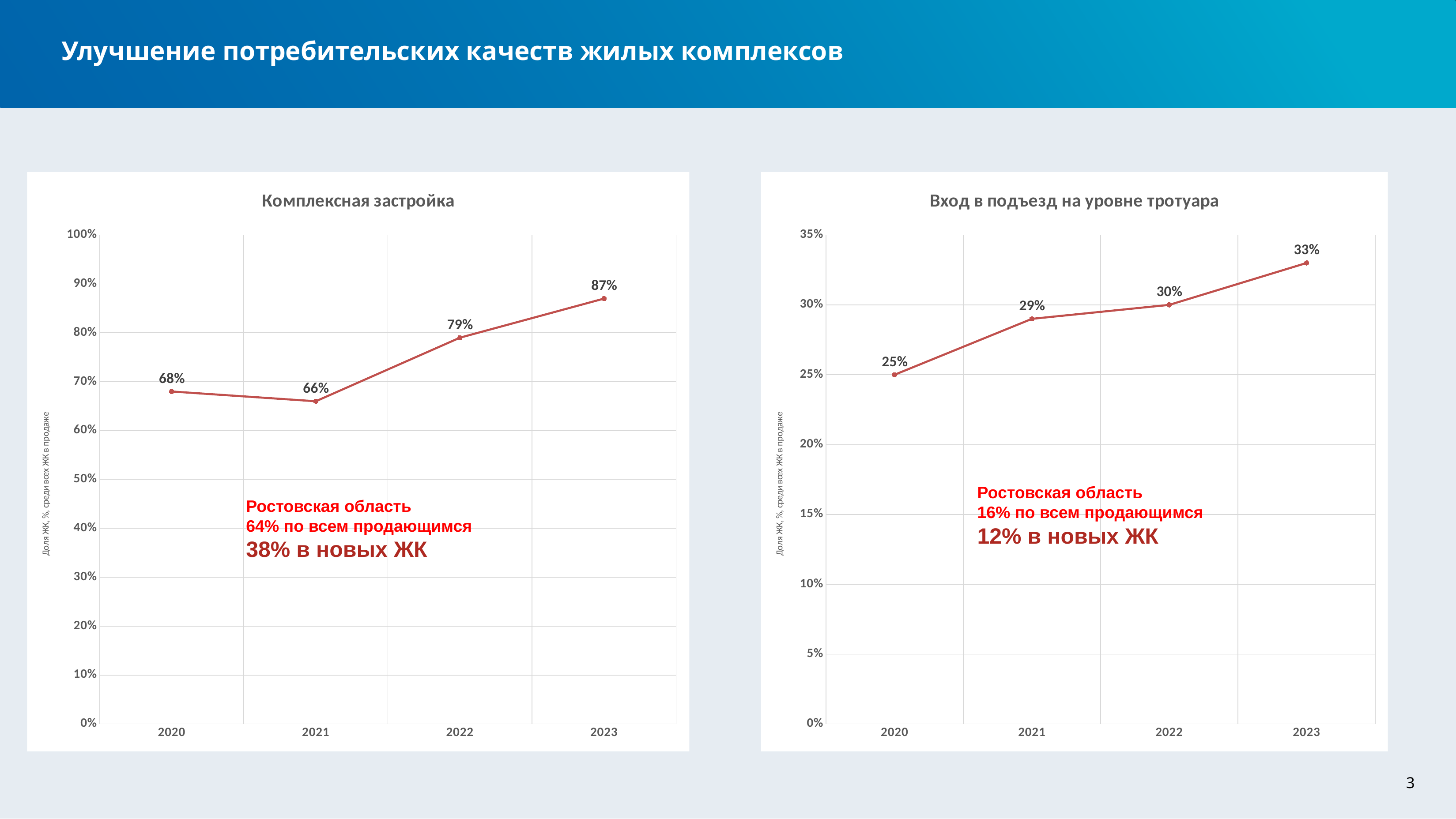
In the chart titled "Вход в подъезд на уровне тротуара", what is the value for 2022? 30% In the chart titled "Комплексная застройка", what kind of chart is it? Line chart In the chart titled "Комплексная застройка", what is the difference between the 2023 and 2020 values? 19% In the chart titled "Комплексная застройка", what is the value for 2023? 87% In the chart titled "Вход в подъезд на уровне тротуара", which is larger: the value for 2021 or the value for 2023? 2023 In the chart titled "Комплексная застройка", which year has the lowest value? 2021 In the chart titled "Вход в подъезд на уровне тротуара", what is the value for 2020? 25% In the chart titled "Вход в подъезд на уровне тротуара", what is the difference between the 2021 and 2020 values? 4% In the chart titled "Вход в подъезд на уровне тротуара", which year has the highest value? 2023 In the chart titled "Комплексная застройка", what is the value for 2021? 66% In the chart titled "Вход в подъезд на уровне тротуара", do the values rise or fall from 2020 to 2023? Rise In the chart titled "Комплексная застройка", how many data points are plotted? 4